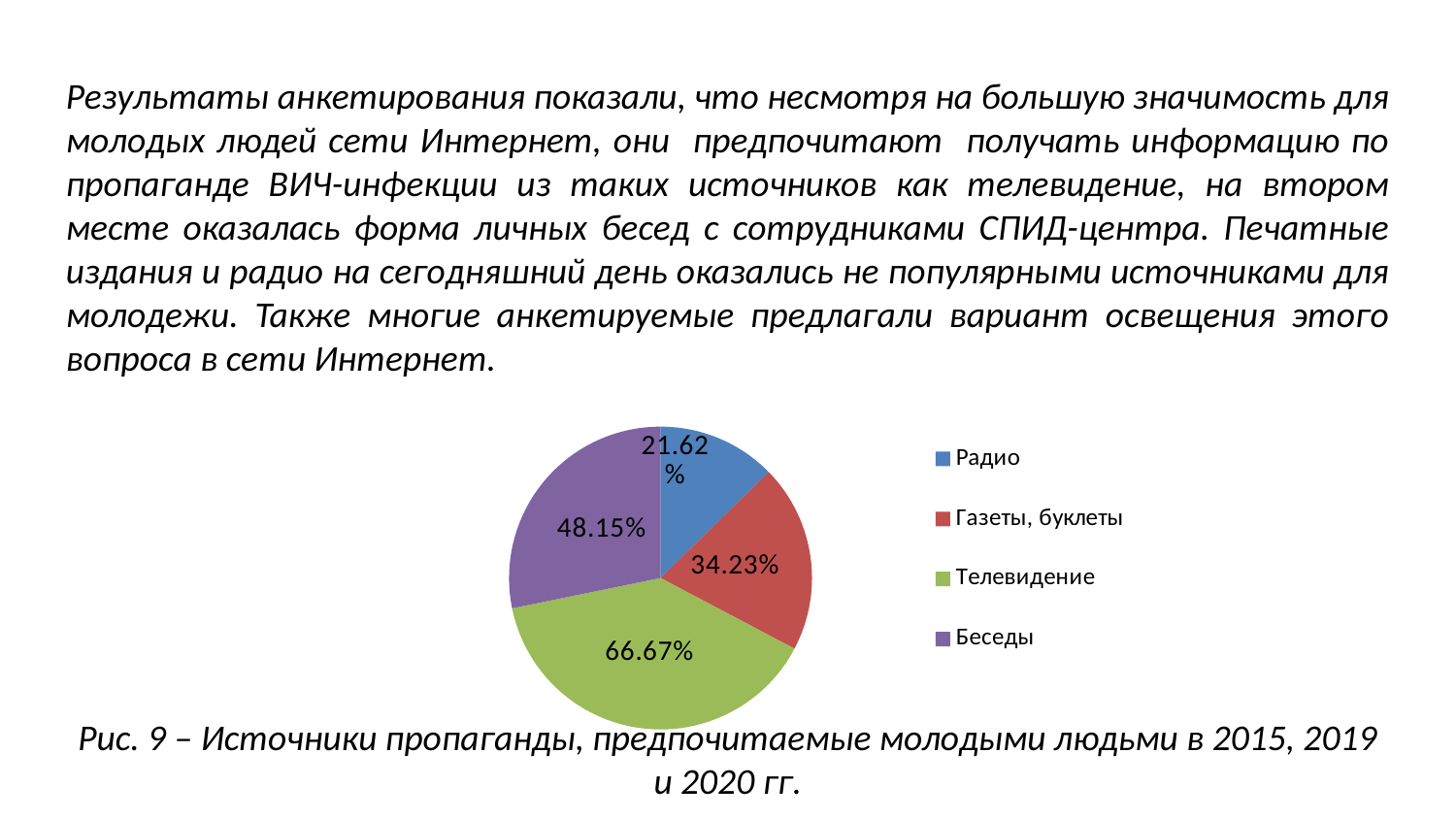
What percentage is shown for the Газеты, буклеты slice? 34.23% What colour is the Телевидение slice in the pie chart? green What percentage is shown for the Телевидение slice? 66.67% Which category has the smallest slice of the pie? Радио Which category has the largest slice of the pie? Телевидение What percentage is shown for the Радио slice? 21.62% How many categories does the legend of the pie chart list? 4 What kind of chart is shown on the slide? pie chart What percentage is shown for the Беседы slice? 48.15% Which is larger, the value for Беседы or the value for Газеты, буклеты? Беседы What is the difference between the values for Телевидение and Беседы? 18.52% What is the difference between the values for Газеты, буклеты and Радио? 12.61%